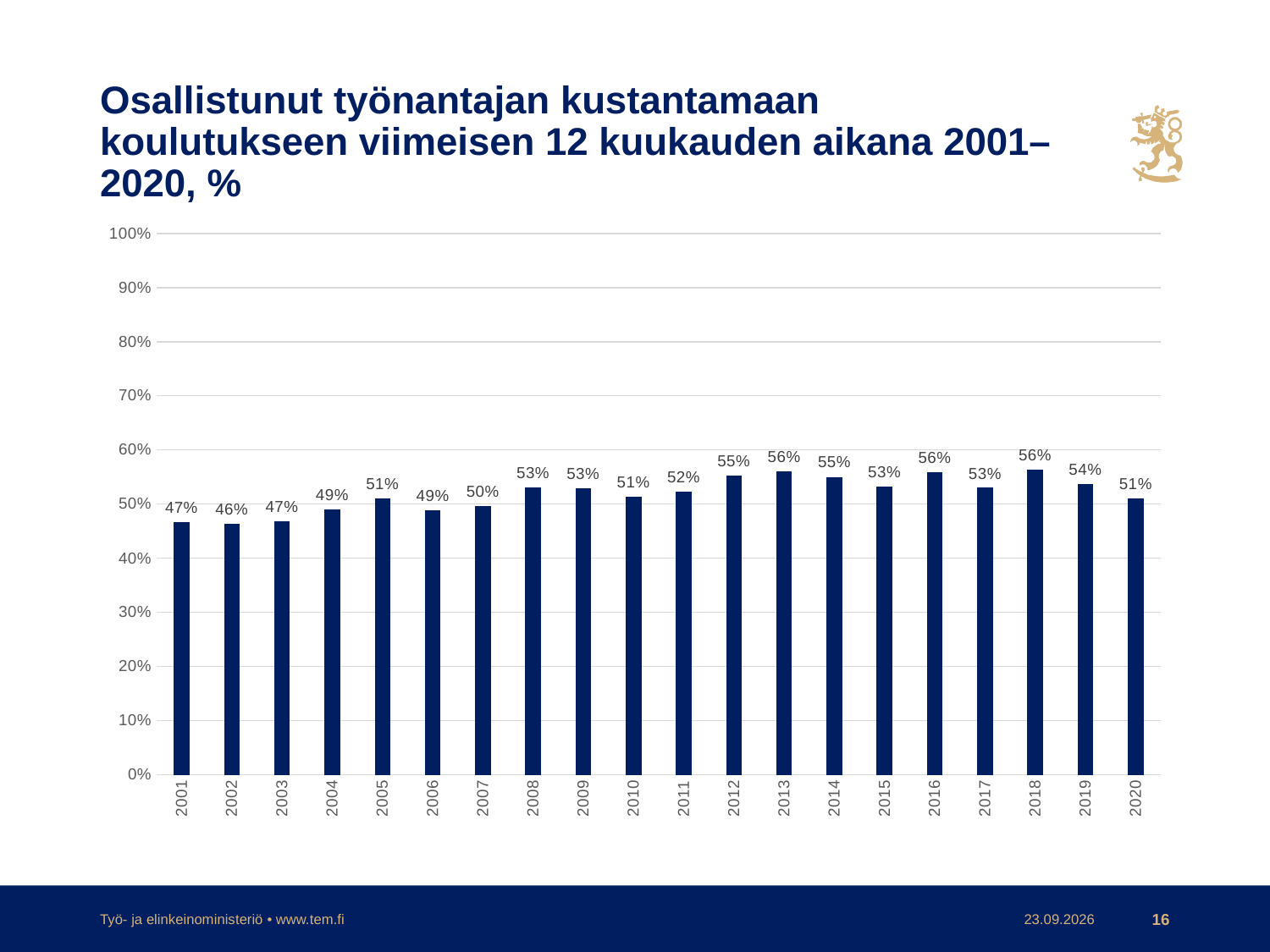
What is the highest value shown in the chart? 56% What is the value for 2001? 47% What is the difference between the values for 2013 and 2001? 9 percentage points Which is larger, the value for 2012 or the value for 2020? 2012 Do the values rise or fall from 2001 to 2005? rise Which year has the lowest value? 2002 What is the value for 2013? 56% How many years are shown on the x axis? 20 What is the value for 2019? 54% Is the value for 2002 greater or less than 50%? less What is the value for 2020? 51% What kind of chart is shown on the slide? bar chart